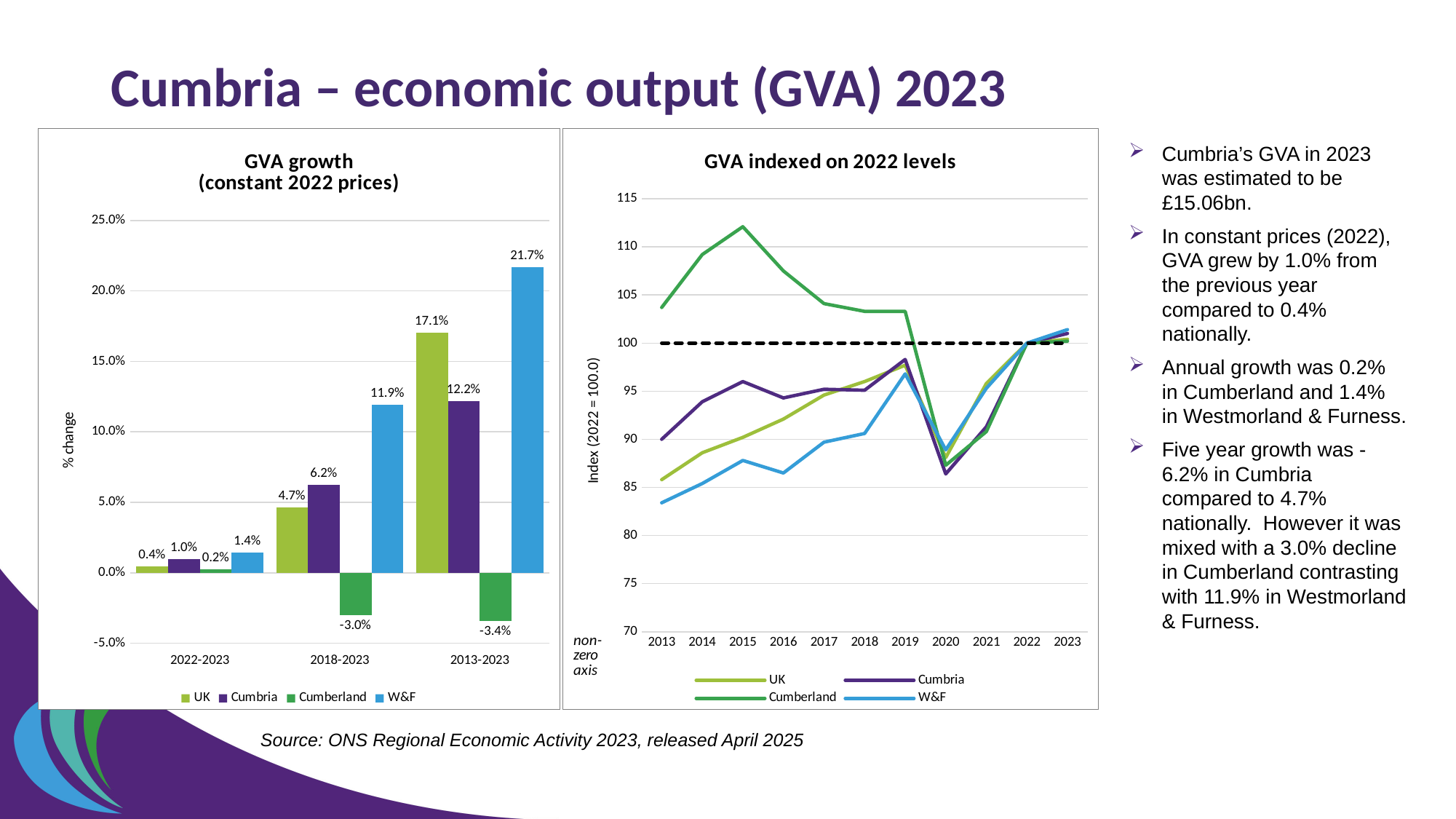
In the GVA growth (constant 2022 prices) chart, which series has the lowest value in 2022-2023? Cumberland In the GVA growth (constant 2022 prices) chart, what is the value for W&F in 2013-2023? 21.7% In the GVA indexed on 2022 levels chart, is the value for W&F in 2013 greater or less than 85? less In the GVA growth (constant 2022 prices) chart, what is the value for Cumberland in 2018-2023? -3.0% In the GVA growth (constant 2022 prices) chart, what is the value for Cumbria in 2022-2023? 1.0% In the GVA growth (constant 2022 prices) chart, which series has the highest value in 2013-2023? W&F In the GVA indexed on 2022 levels chart, is the value for Cumberland in 2015 greater or less than 110? greater What kind of chart is the GVA indexed on 2022 levels chart? Line chart In the GVA growth (constant 2022 prices) chart, what is the difference between the UK and Cumbria values in 2013-2023? 4.9% How many series does the legend of the GVA growth (constant 2022 prices) chart list? 4 In the GVA growth (constant 2022 prices) chart, which is larger in 2018-2023: UK or Cumbria? Cumbria How many years are shown on the x axis of the GVA indexed on 2022 levels chart? 11